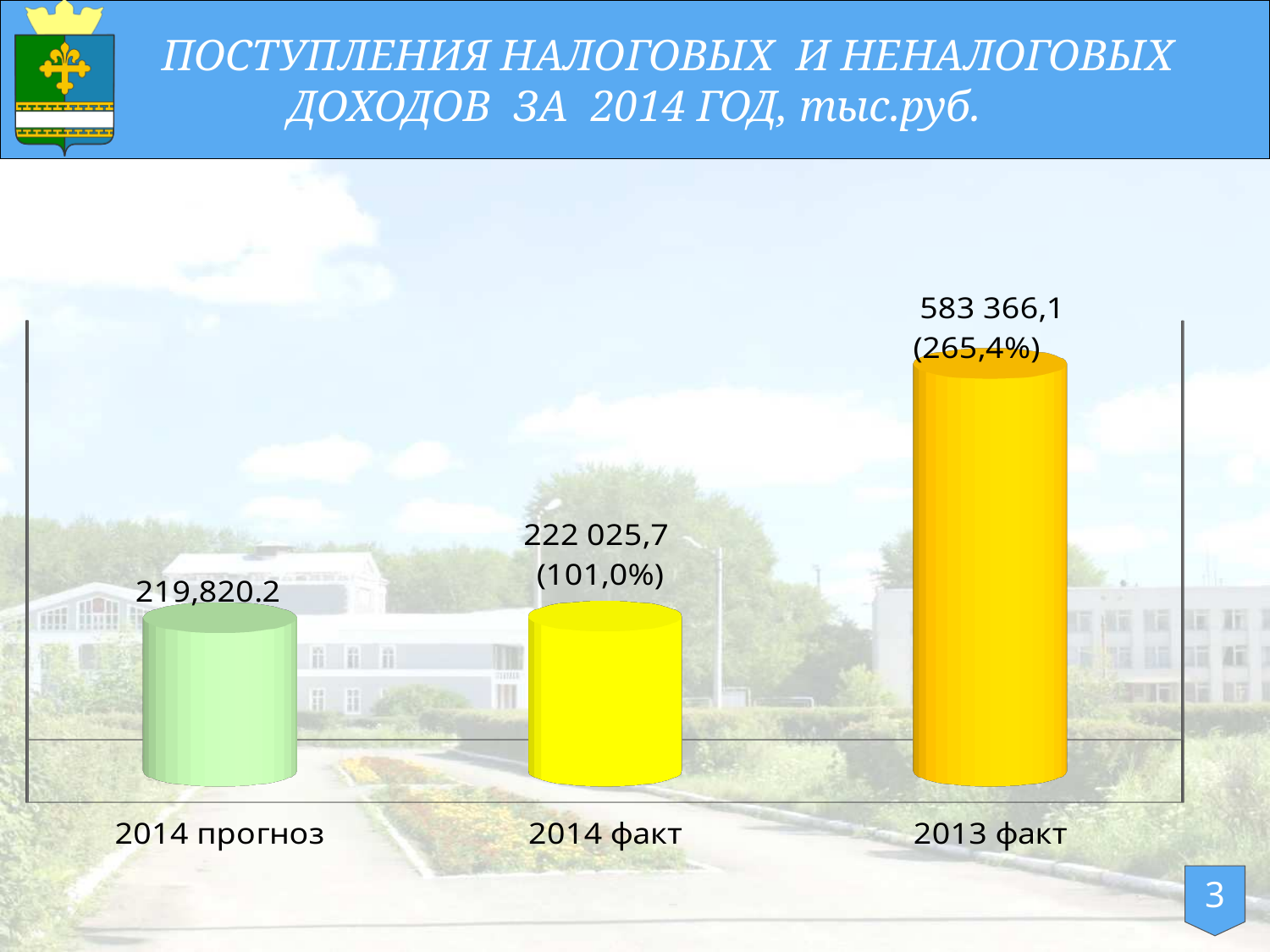
What kind of chart is shown on the slide? Bar chart What percentage is shown in parentheses for 2014 факт? 101,0% What is the value for 2014 факт? 222 025,7 What is the value for 2014 прогноз? 219,820.2 Which category has the lowest value? 2014 прогноз How many categories are shown on the chart? 3 What percentage is shown in parentheses for 2013 факт? 265,4% What colour is the bar for 2013 факт? Orange What is the difference between the values for 2013 факт and 2014 факт? 361 340,4 Which is larger, the value for 2013 факт or the value for 2014 факт? 2013 факт Which category has the highest value? 2013 факт What is the value for 2013 факт? 583 366,1